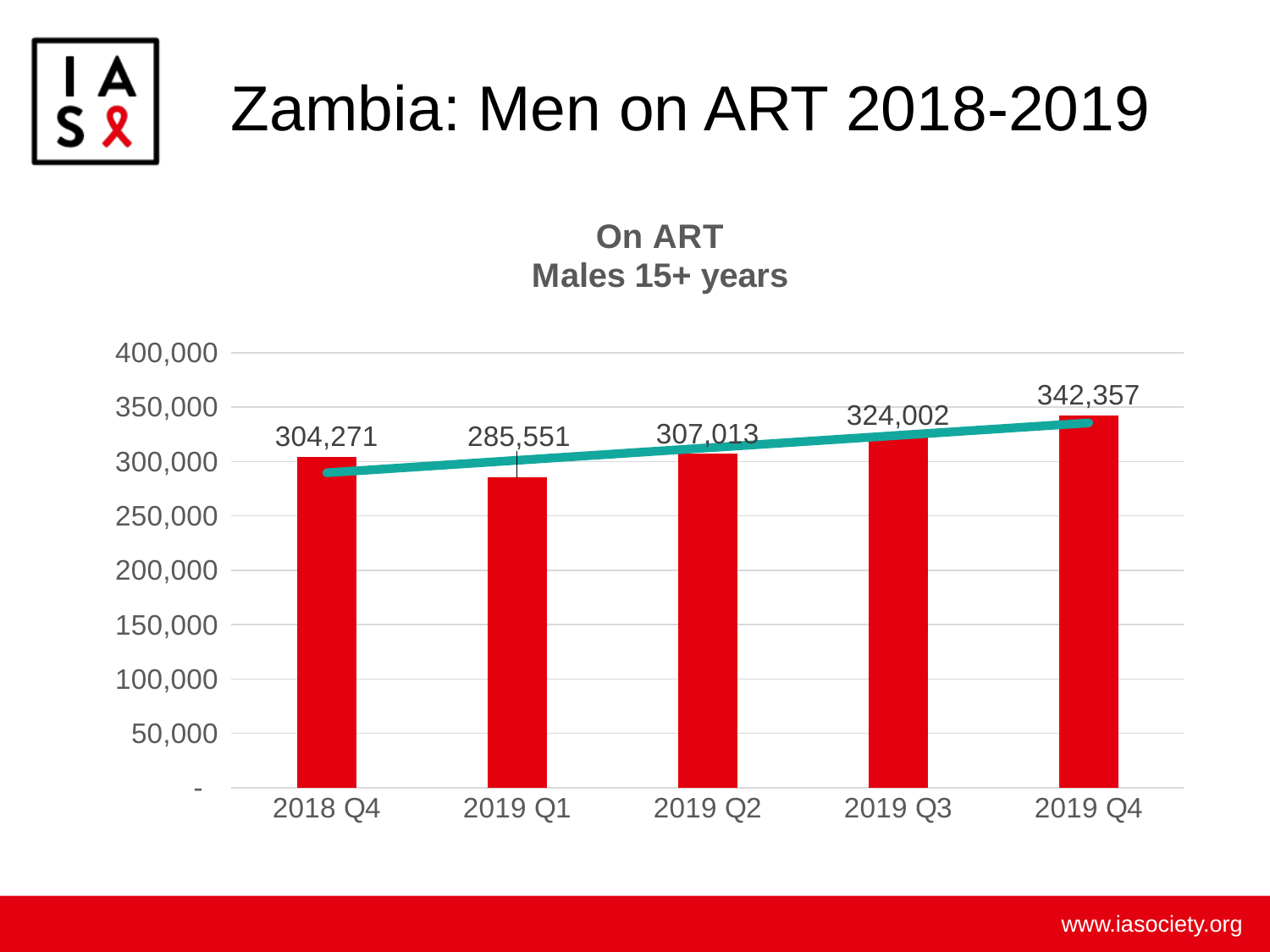
Which quarter has the highest value? 2019 Q4 What is the difference between the values for 2018 Q4 and 2019 Q1? 18,720 What is the difference between the values for 2019 Q4 and 2019 Q3? 18,355 Which is larger, the value for 2019 Q2 or the value for 2018 Q4? 2019 Q2 Which quarter has the lowest value? 2019 Q1 What kind of chart is this? bar chart What is the value for 2019 Q3? 324,002 What is the value for 2018 Q4? 304,271 Is the value for 2019 Q1 greater or less than 300,000? less How many quarters are shown on the x axis? 5 What is the value for 2019 Q1? 285,551 What is the value for 2019 Q4? 342,357